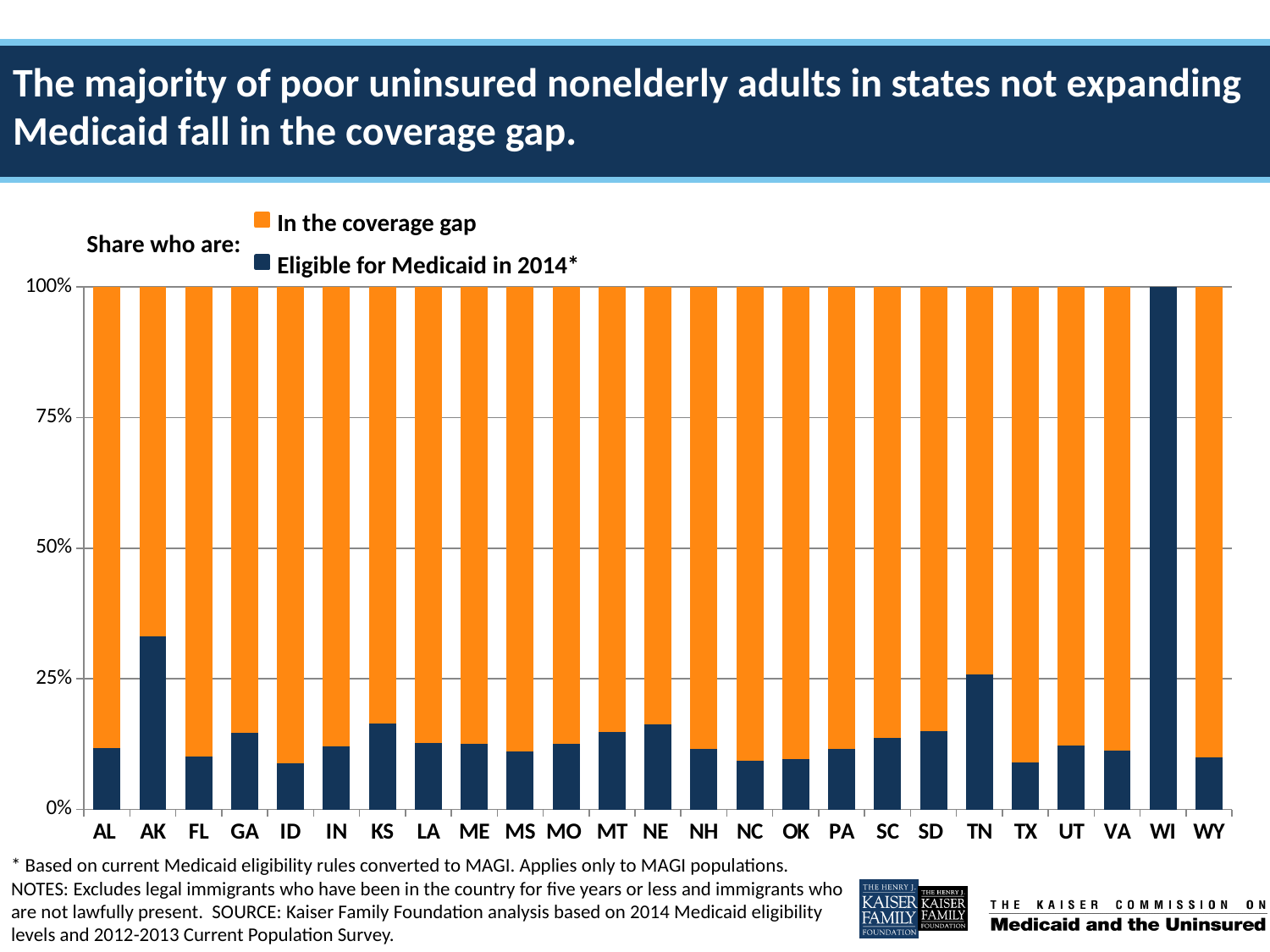
What is the share eligible for Medicaid in 2014 for WI? 100% Is the share in the coverage gap for AL greater or less than 75%? greater Is the share eligible for Medicaid in 2014 for AK greater or less than 25%? greater Which state has the highest share eligible for Medicaid in 2014? WI What label appears to the left of the legend on the chart? Share who are: What kind of chart is shown on the slide? stacked bar chart Which series is shown in orange in the chart? In the coverage gap Which state has the lowest share in the coverage gap? WI Is the share eligible for Medicaid in 2014 for TX greater or less than 25%? less Which is larger for AK: the share in the coverage gap or the share eligible for Medicaid in 2014? In the coverage gap How many states are shown along the x axis of the chart? 25 How many series does the chart's legend list? 2